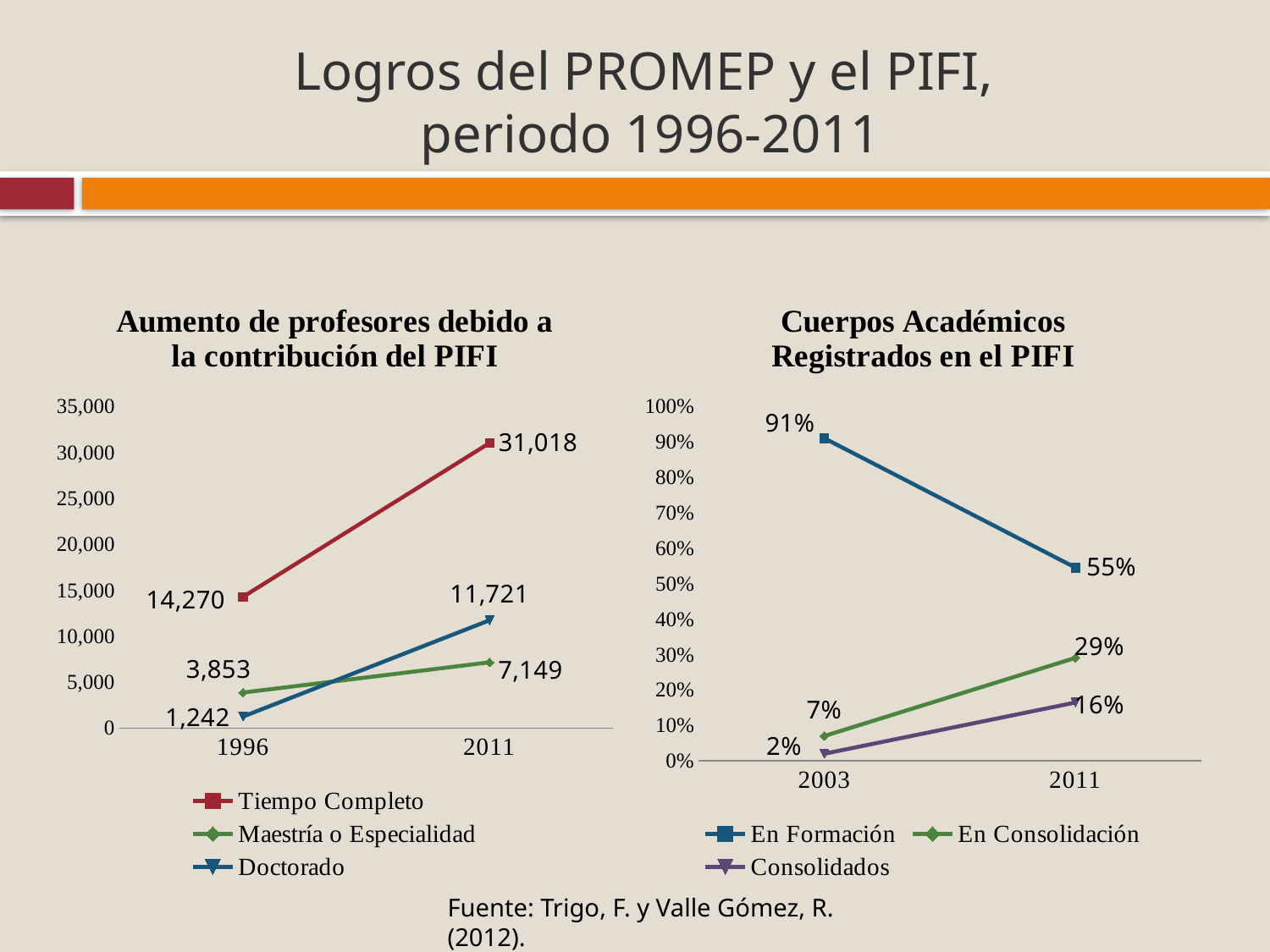
How many series does the legend of the chart 'Aumento de profesores debido a la contribución del PIFI' list? 3 What kind of chart is 'Cuerpos Académicos Registrados en el PIFI'? Line chart In the chart 'Aumento de profesores debido a la contribución del PIFI', which is larger in 2011: Maestría o Especialidad or Doctorado? Doctorado In the chart 'Aumento de profesores debido a la contribución del PIFI', what is the value for Tiempo Completo in 2011? 31,018 In the chart 'Aumento de profesores debido a la contribución del PIFI', what is the value for Doctorado in 1996? 1,242 In the chart 'Cuerpos Académicos Registrados en el PIFI', what is the value for Consolidados in 2011? 16% In the chart 'Cuerpos Académicos Registrados en el PIFI', which series has the highest value in 2011? En Formación In the chart 'Aumento de profesores debido a la contribución del PIFI', which series has the lowest value in 1996? Doctorado In the chart 'Cuerpos Académicos Registrados en el PIFI', what is the difference between the En Consolidación values for 2011 and 2003? 22% In the chart 'Cuerpos Académicos Registrados en el PIFI', does the En Formación series rise or fall from 2003 to 2011? Fall In the chart 'Cuerpos Académicos Registrados en el PIFI', what is the value for En Formación in 2003? 91% In the chart 'Aumento de profesores debido a la contribución del PIFI', what is the difference between the Tiempo Completo values for 2011 and 1996? 16,748